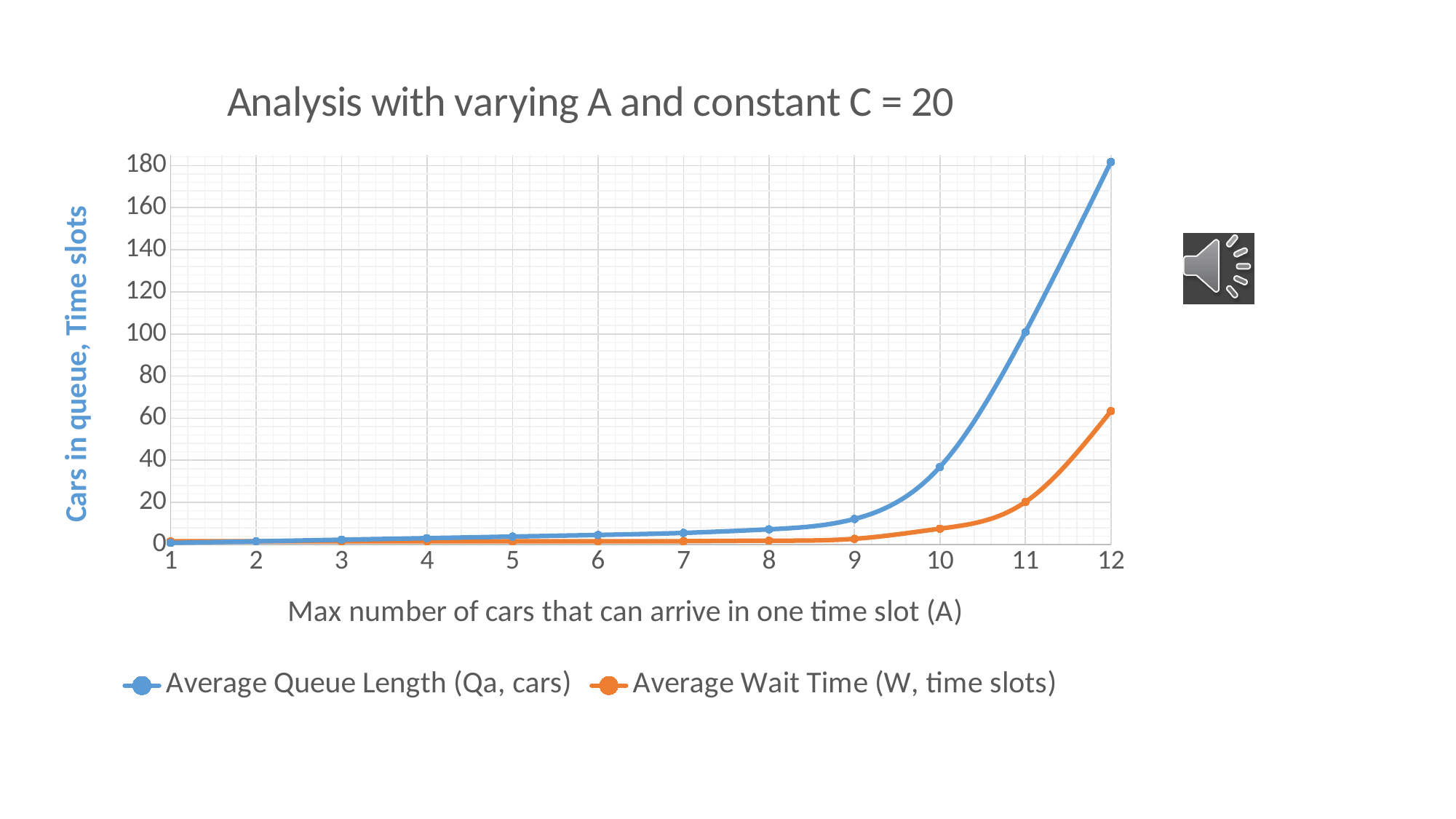
Is the Average Queue Length at A = 12 greater or less than 160? greater At which value of A is the Average Queue Length highest? 12 At which value of A is the Average Wait Time highest? 12 Is the Average Wait Time at A = 11 greater or less than 40? less Is the Average Wait Time at A = 12 greater or less than 80? less What is the title of the chart? Analysis with varying A and constant C = 20 At A = 12, which series has the larger value, Average Queue Length or Average Wait Time? Average Queue Length Do the values of Average Queue Length rise or fall as A increases from 1 to 12? rise What kind of chart is shown on the slide? line chart How many series does the legend list? 2 How many data points does each series have along the x axis? 12